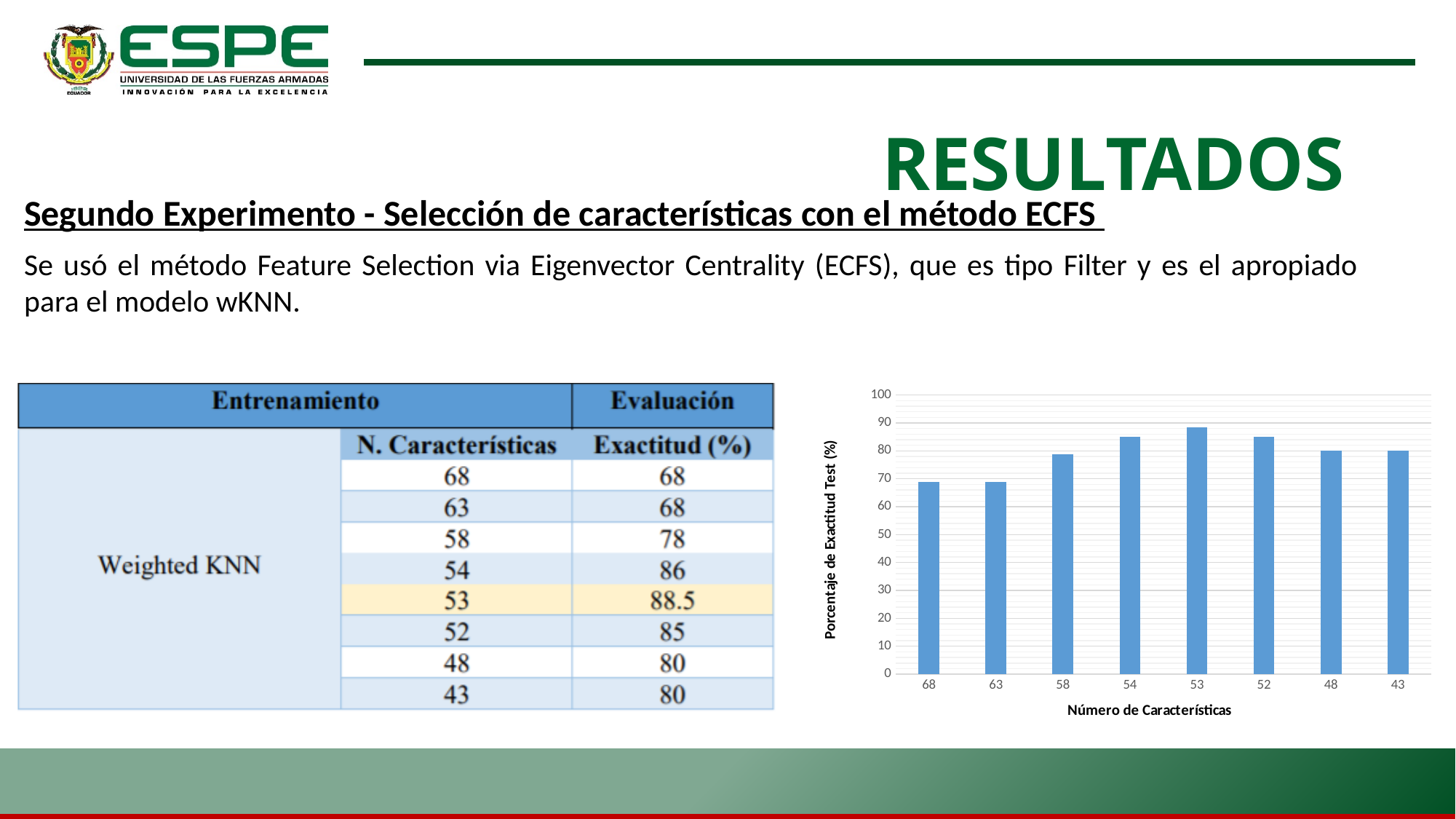
What kind of chart is shown on the right of the slide? bar chart What is the test accuracy for 53 characteristics? 88.5 Is the value for 68 characteristics greater or less than 70? less What is the label of the vertical axis of the chart? Porcentaje de Exactitud Test (%) What is the test accuracy for 48 characteristics? 80 Which number of characteristics gives the highest test accuracy in the chart? 53 Which is larger, the accuracy for 58 characteristics or for 53 characteristics? 53 characteristics What is the label of the horizontal axis of the chart? Número de Características How many bars (number-of-characteristics categories) does the chart show? 8 Is the value for 54 characteristics greater or less than 80? greater What is the difference between the accuracy for 53 characteristics and for 43 characteristics? 8.5